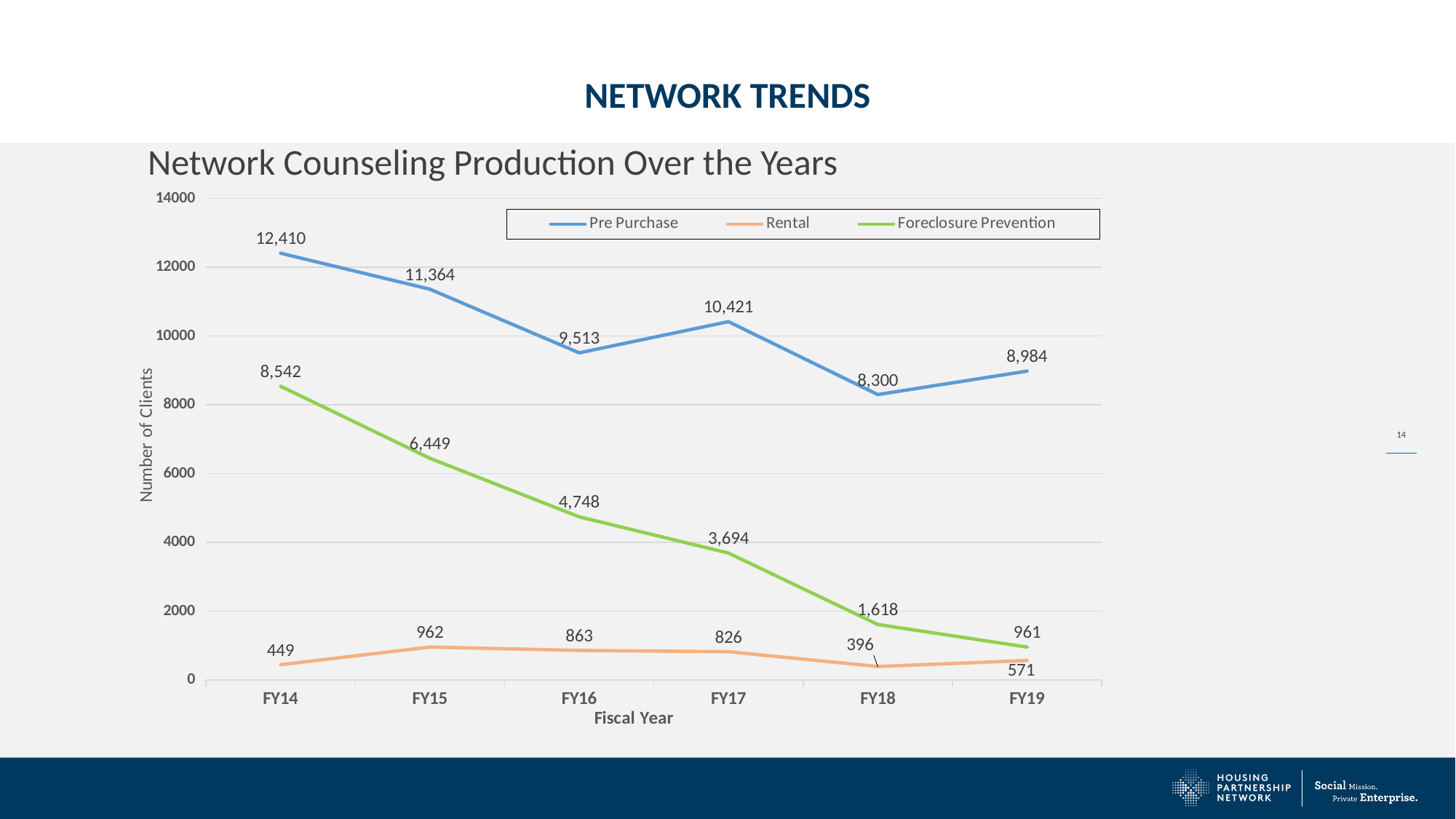
Does the Foreclosure Prevention line rise or fall from FY14 to FY19? Fall How many fiscal years are plotted on the x axis? 6 How many series does the legend list? 3 What is the Pre Purchase value for FY14? 12,410 In which fiscal year is the Pre Purchase value lowest? FY18 What is the label of the y axis? Number of Clients What is the difference between the Pre Purchase values for FY14 and FY19? 3,426 What type of chart is shown on the slide? Line chart In which fiscal year is the Foreclosure Prevention value highest? FY14 What is the Foreclosure Prevention value for FY17? 3,694 What is the Rental value for FY15? 962 Which is larger, the Rental value for FY19 or the Foreclosure Prevention value for FY19? Foreclosure Prevention (961)